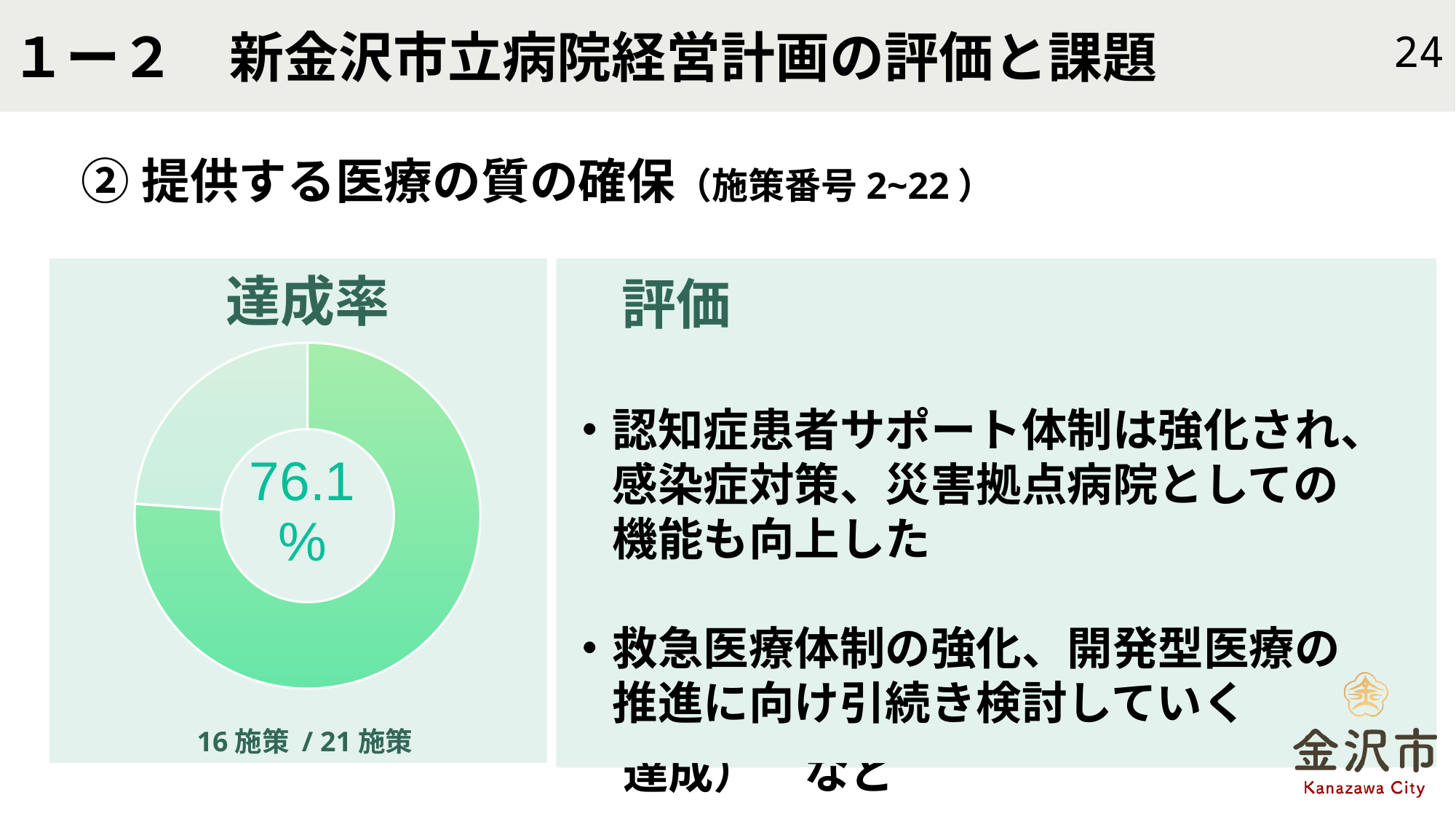
Is the achieved share shown in the 達成率 donut chart greater or less than 50%? greater Which policy area (施策番号) does the 達成率 donut chart on this slide refer to? ② 提供する医療の質の確保（施策番号 2~22） How many slices does the 達成率 donut chart have? 2 What kind of chart is shown under the heading 達成率? Donut (pie) chart In the 達成率 donut chart, which slice is larger: the darker green (achieved) slice or the lighter (not achieved) slice? The darker green (achieved) slice What is the title shown above the donut chart? 達成率 What share of the 達成率 donut does the larger (achieved) slice represent? 76.1% What value is printed in the centre of the 達成率 donut chart? 76.1% According to the caption below the donut chart, how many measures were achieved out of how many? 16 施策 / 21 施策